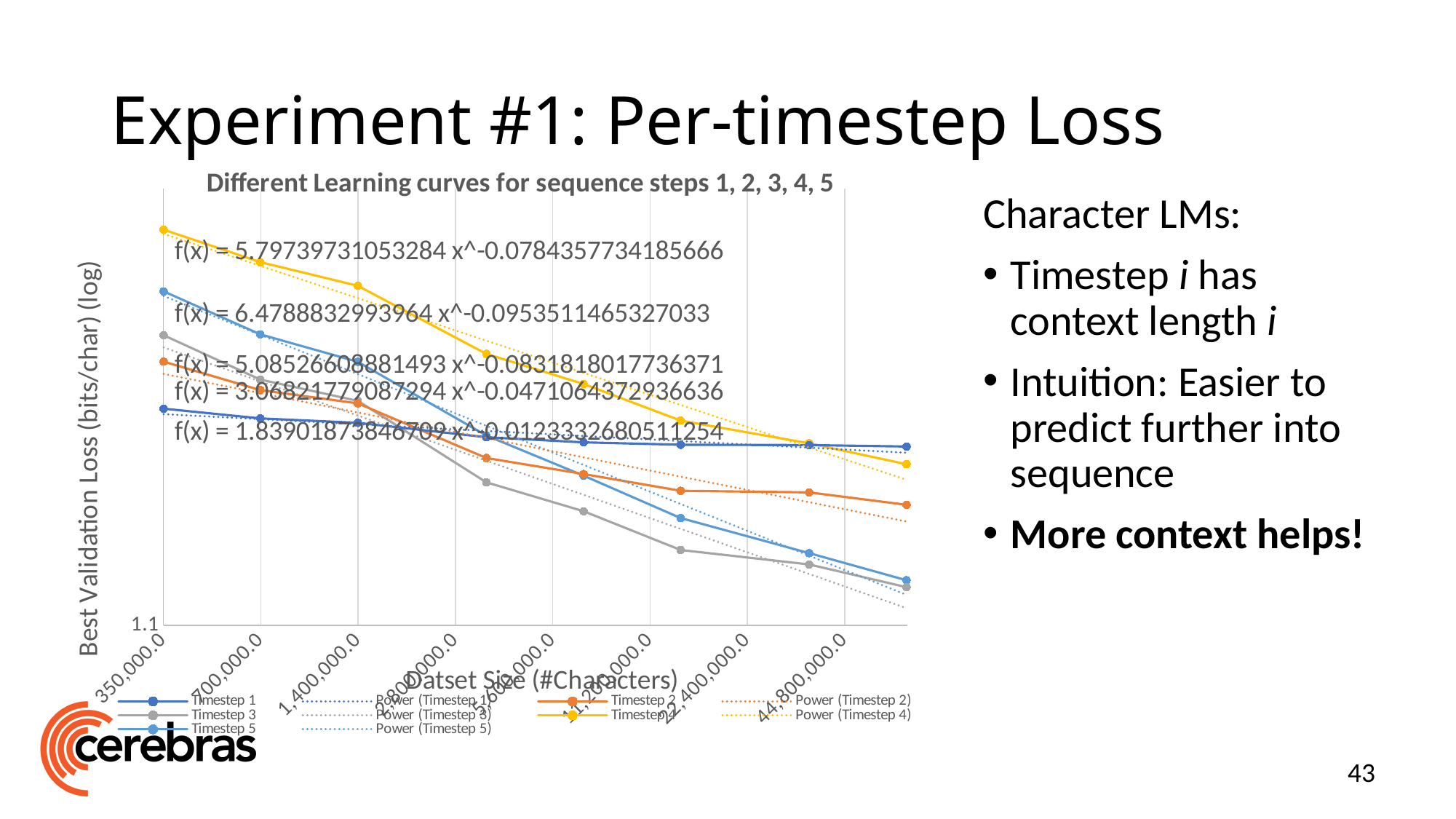
What is the title of the chart? Different Learning curves for sequence steps 1, 2, 3, 4, 5 Which series has the lowest value at the leftmost point (350,000.0)? Timestep 1 Which series has the highest value at the leftmost point (350,000.0)? Timestep 4 Do the Timestep 5 values rise or fall as dataset size increases along the x axis? fall What is the label of the x axis? Datset Size (#Characters) What is the last x-axis tick label on the chart? 44,800,000.0 At the rightmost data point, which series has the larger value: Timestep 1 or Timestep 5? Timestep 1 What is the first x-axis tick label on the chart? 350,000.0 How many entries does the chart's legend list? 10 At the rightmost data point, which series has the larger value: Timestep 4 or Timestep 2? Timestep 4 How many tick labels are shown on the x axis of the chart? 8 What kind of chart is shown on the slide? line chart